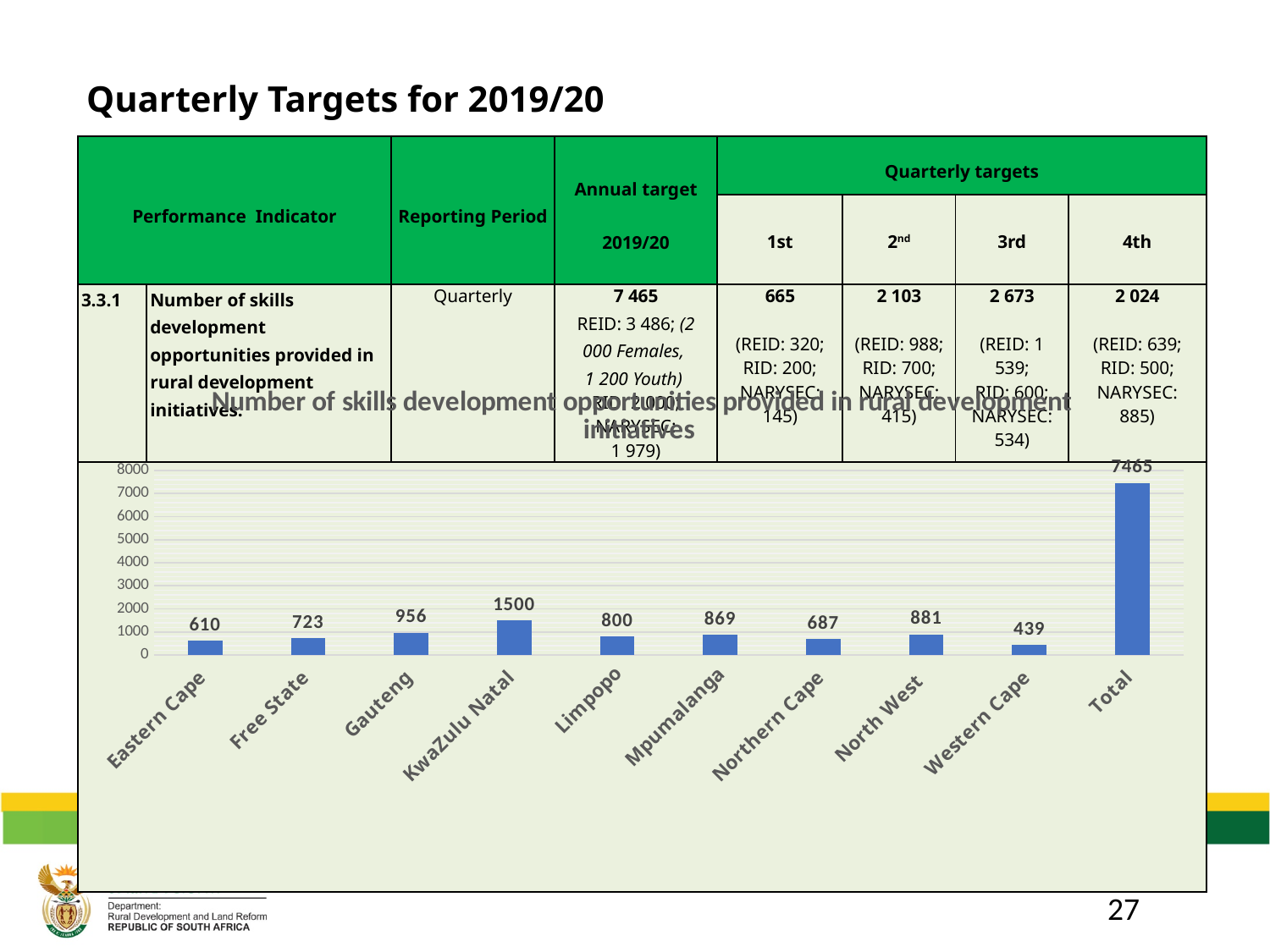
What is the value for Western Cape in the bar chart? 439 Is the value for Mpumalanga in the chart greater or less than 1000? less What is the difference between the values for North West and Limpopo in the chart? 81 Which province has the lowest value in the chart? Western Cape What is the value for KwaZulu Natal in the bar chart? 1500 Excluding the Total bar, which province has the highest value in the chart? KwaZulu Natal What is the difference between the values for KwaZulu Natal and Eastern Cape in the chart? 890 How many bars are plotted in the chart, including the Total bar? 10 What is the value shown for the Total bar in the chart? 7465 What is the value for Gauteng in the bar chart? 956 What type of chart is shown on the slide? Bar chart Which is larger in the chart, the value for Free State or the value for Northern Cape? Free State